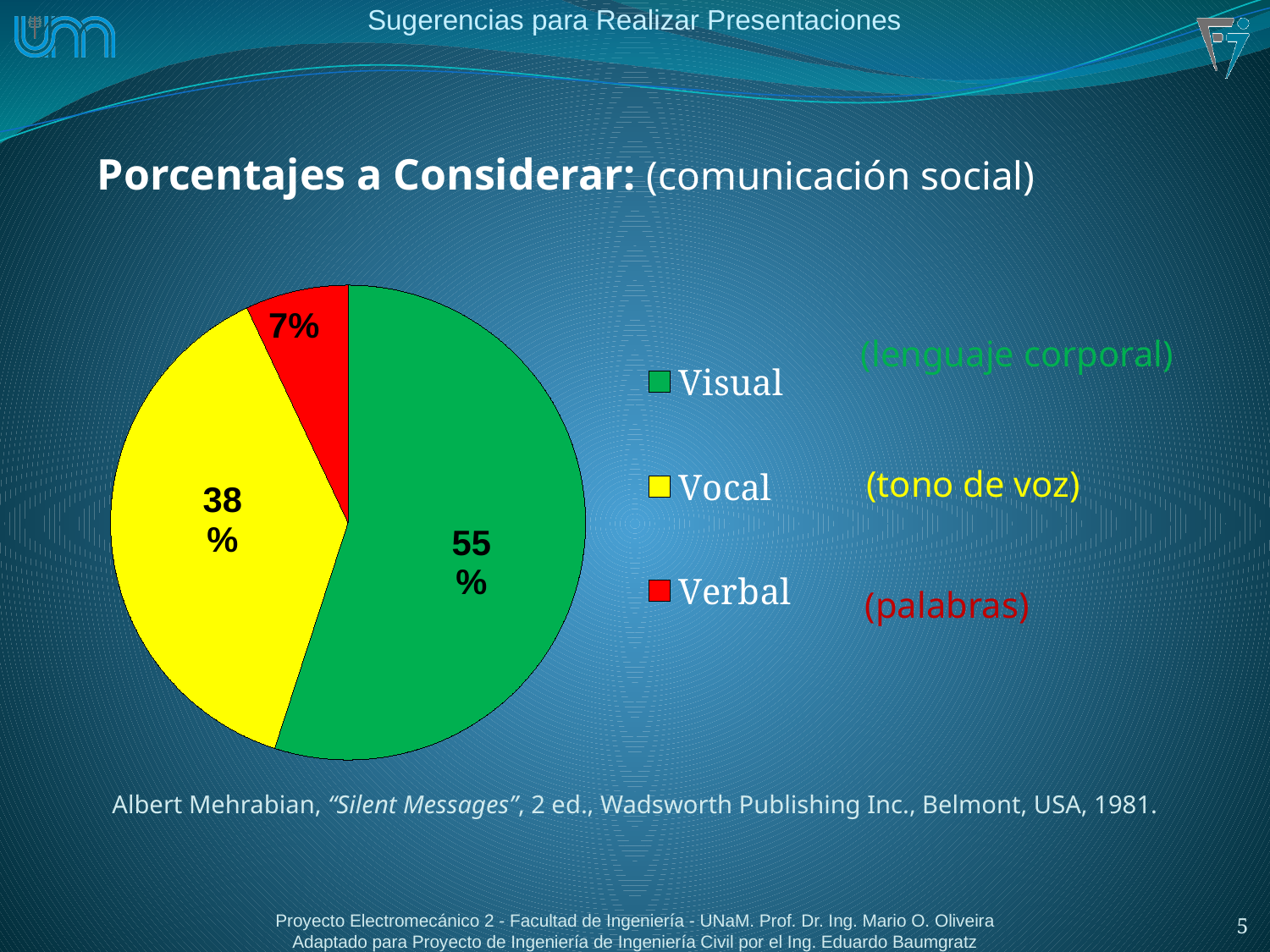
How many entries does the legend list? 3 What percentage does the Verbal slice represent? 7% Which is larger, the Vocal slice or the Verbal slice? Vocal Which category has the largest slice of the pie? Visual How many slices does the pie chart have? 3 What colour is the Vocal slice in the pie chart? yellow What kind of chart is shown on the slide? pie chart What percentage does the Visual slice represent? 55% What is the difference in percentage points between the Vocal and Verbal slices? 31 What is the difference in percentage points between the Visual and Vocal slices? 17 What percentage does the Vocal slice represent? 38% Which category has the smallest slice of the pie? Verbal